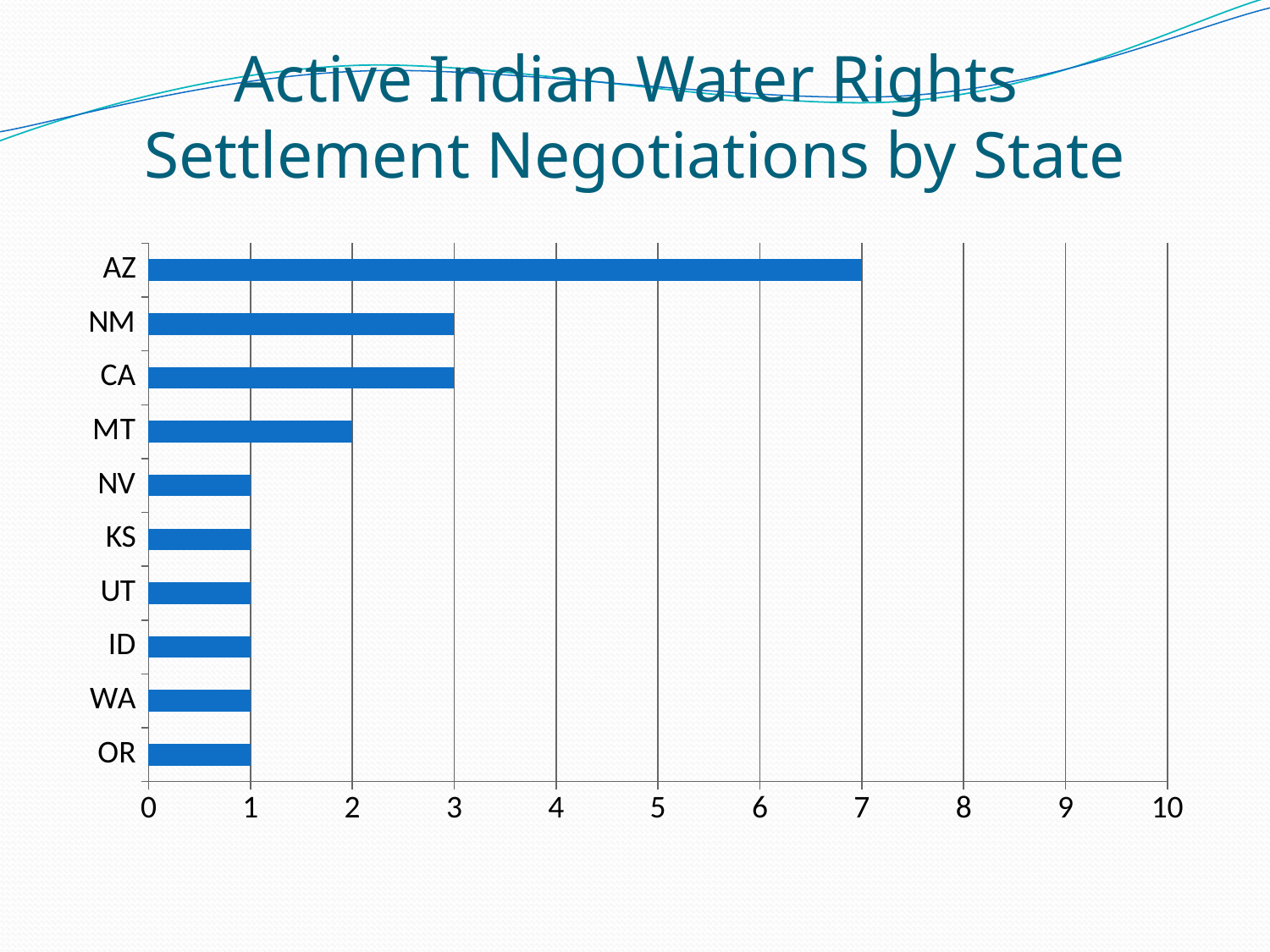
Is the value for AZ greater or less than 5? greater What is the difference between the values for MT and OR? 1 Which state has the highest value? AZ How many states are shown on the chart? 10 What kind of chart is shown on the slide? bar chart What is the value for NM? 3 What is the difference between the values for AZ and CA? 4 What is the value for AZ? 7 What is the value for MT? 2 What is the title of the slide? Active Indian Water Rights Settlement Negotiations by State Which is larger, the value for NM or the value for MT? NM How many states have a value of 1? 6